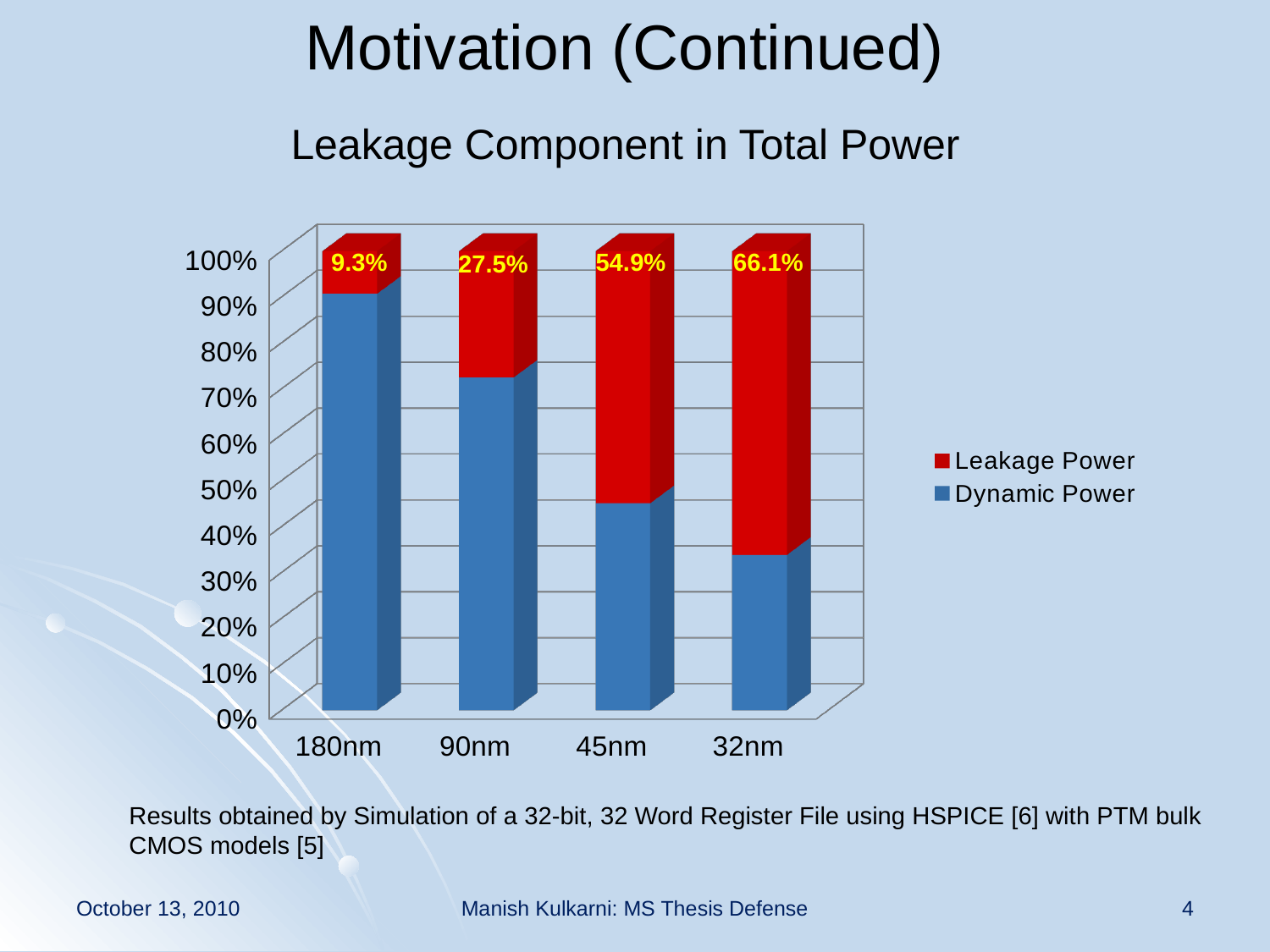
Which has a larger Leakage Power percentage, 90nm or 45nm? 45nm What is the Leakage Power percentage for 45nm? 54.9% Does the Leakage Power percentage rise or fall from 180nm to 32nm along the x axis? rise How many series does the legend list? 2 How many technology nodes are shown on the x axis? 4 Which technology node has the lowest Leakage Power percentage? 180nm What is the Leakage Power percentage for 32nm? 66.1% What is the difference between the Leakage Power percentages for 32nm and 180nm? 56.8% Which technology node has the highest Leakage Power percentage? 32nm What is the Leakage Power percentage for 180nm? 9.3% What is the Leakage Power percentage for 90nm? 27.5% Is the Dynamic Power share for 32nm greater or less than 40%? less